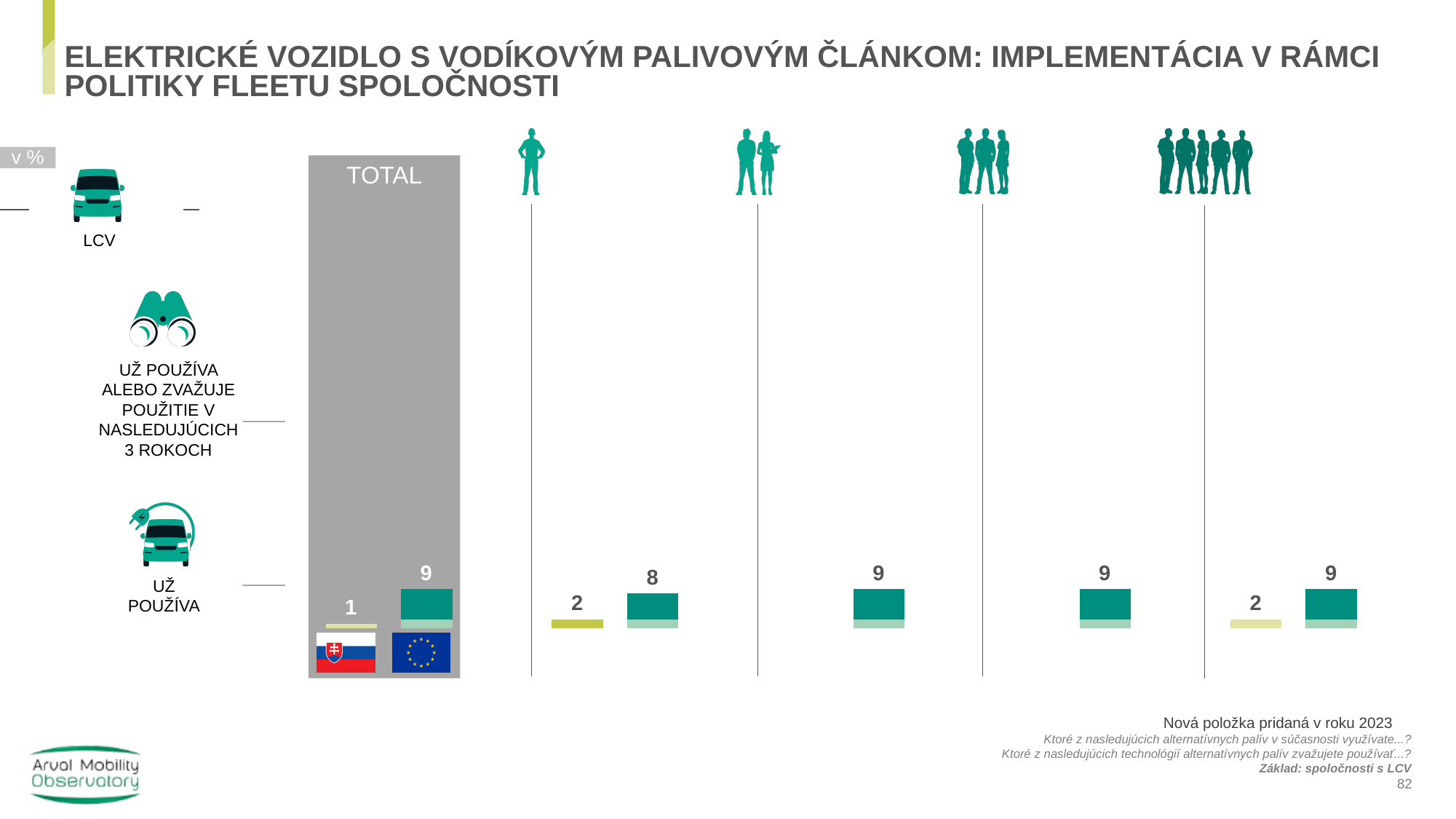
In the TOTAL column, what is the difference between the EU flag value and the Slovak flag value? 8 For the first group to the right of TOTAL (single person icon), what is the value of the yellow-green (Slovak) bar? 2 For the rightmost group (largest group of people icons), what is the difference between the teal (EU) value and the yellow-green (Slovak) value? 7 In what unit are the values on the chart expressed, according to the label at the top left? % In the TOTAL column, what value is shown for the bar with the Slovak flag? 1 What kind of chart is shown on the slide? Bar chart In the TOTAL column, which bar is larger, the Slovak flag bar or the EU flag bar? EU flag bar For the rightmost group (largest group of people icons), what is the value of the teal (EU) bar? 9 In the TOTAL column, what value is shown for the bar with the EU flag? 9 For the first group to the right of TOTAL (single person icon), what is the value of the teal (EU) bar? 8 Among the teal (EU) bars, which group has the lowest value? The single person icon group (8) For the rightmost group (largest group of people icons), what is the value of the yellow-green (Slovak) bar? 2